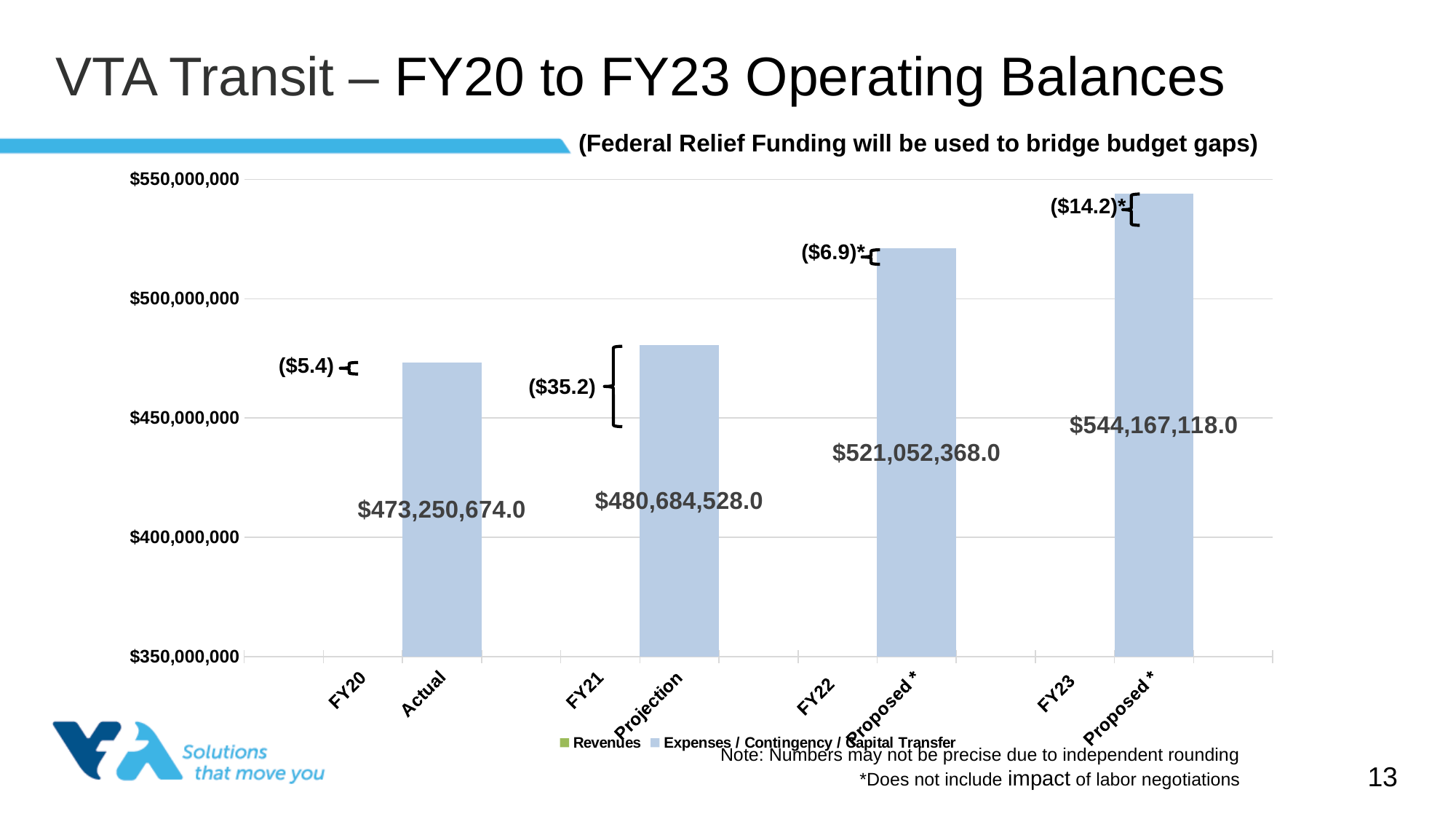
Which fiscal year has the lowest Expenses / Contingency / Capital Transfer bar? FY20 Actual What kind of chart is shown on the slide? Bar chart How many series does the legend list? 2 Which fiscal year has the highest Expenses / Contingency / Capital Transfer bar? FY23 Proposed What is the difference between the FY21 Projection and FY20 Actual Expenses / Contingency / Capital Transfer values? $7,433,854.0 What is the Expenses / Contingency / Capital Transfer value shown for FY21 Projection? $480,684,528.0 Is the FY22 Proposed bar greater or less than $500,000,000? greater How many bars are plotted in the chart? 4 What is the Expenses / Contingency / Capital Transfer value shown for FY20 Actual? $473,250,674.0 What is the Expenses / Contingency / Capital Transfer value shown for FY22 Proposed? $521,052,368.0 What is the Expenses / Contingency / Capital Transfer value shown for FY23 Proposed? $544,167,118.0 What is the difference between the FY23 Proposed and FY22 Proposed Expenses / Contingency / Capital Transfer values? $23,114,750.0